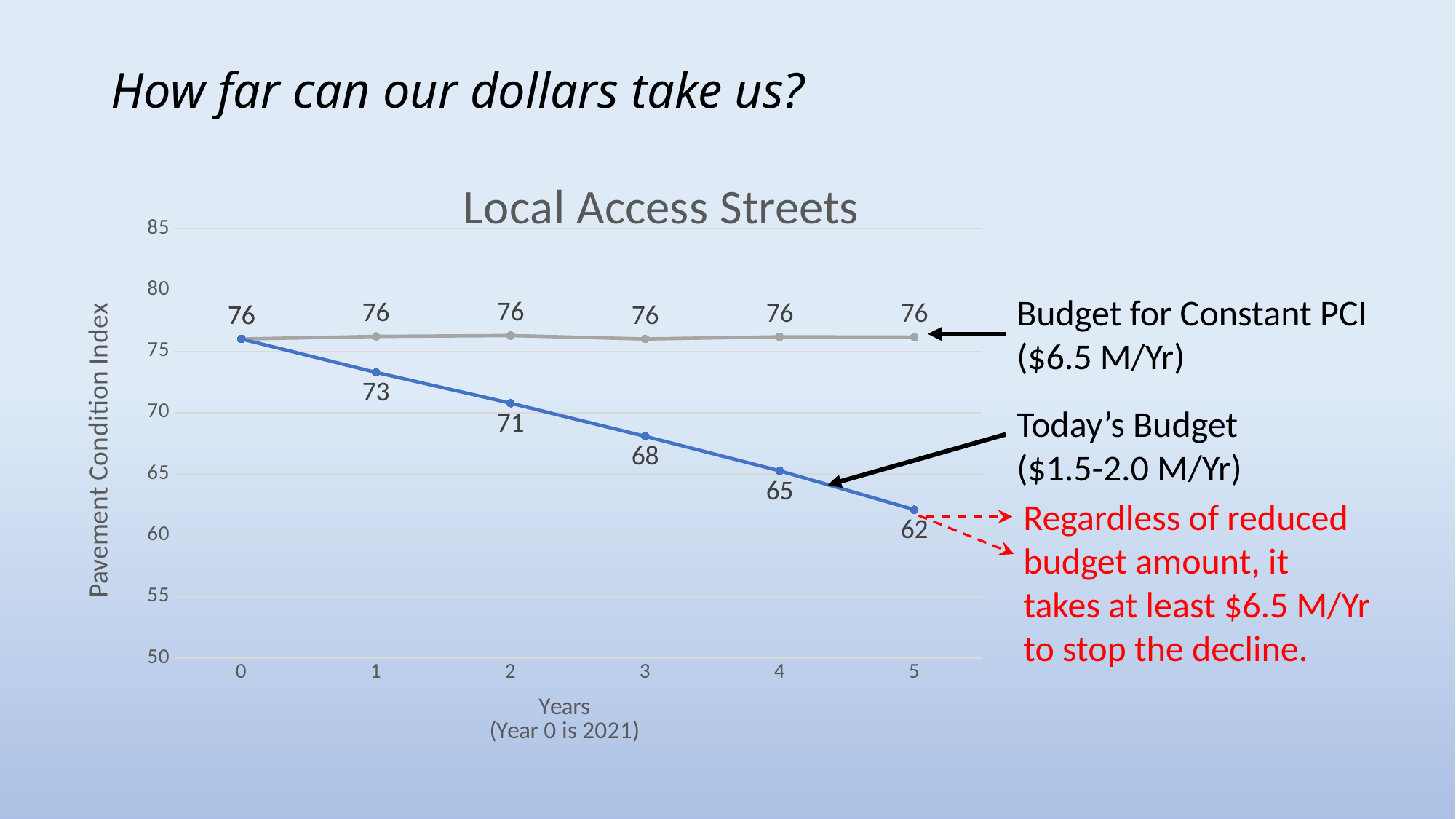
Does the Today's Budget line rise or fall from year 0 to year 5? fall What is the difference between the Today's Budget values at year 0 and year 3? 8 What is the label of the y axis? Pavement Condition Index What kind of chart is shown on the slide? line chart What is the title of the chart? Local Access Streets At which year is the Today's Budget line at its lowest value? 5 How many year points are plotted on the x axis? 6 What is the Pavement Condition Index for Today's Budget at year 2? 71 What is the Pavement Condition Index for Today's Budget at year 5? 62 What is the Pavement Condition Index for Budget for Constant PCI at year 3? 76 What is the difference between the Budget for Constant PCI value and the Today's Budget value at year 5? 14 Which line has the higher value at year 4, Budget for Constant PCI or Today's Budget? Budget for Constant PCI